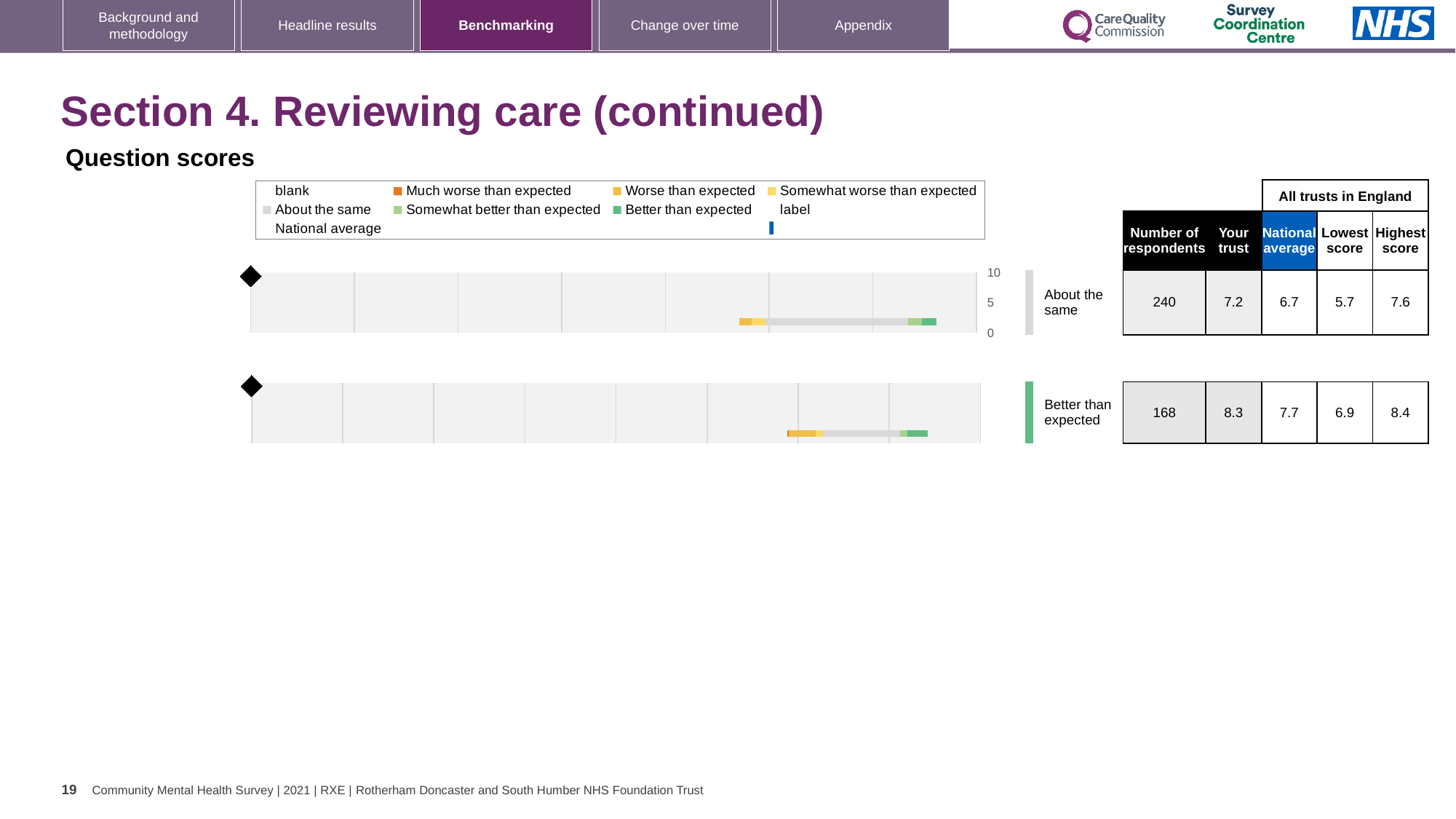
What kind of chart is used for the question scores on this slide? bar chart In the legend, which colour represents 'Much worse than expected'? orange For the bottom chart (labelled 'Better than expected'), what is the highest score across all trusts in England? 8.4 What is the highest value shown on the vertical axis scale next to the top chart? 10 Which chart row has more respondents, the top one ('About the same') or the bottom one ('Better than expected')? the top one ('About the same') For the top chart (labelled 'About the same'), what is the difference between the highest score and the lowest score across all trusts in England? 1.9 For the bottom chart (labelled 'Better than expected'), how many respondents are listed in the table? 168 For the top chart (labelled 'About the same'), what is the national average in the table? 6.7 What is the difference between the 'Your trust' scores of the bottom chart ('Better than expected') and the top chart ('About the same')? 1.1 For the top chart (labelled 'About the same'), what is the 'Your trust' score in the table? 7.2 How many question-score charts are shown on the slide? 2